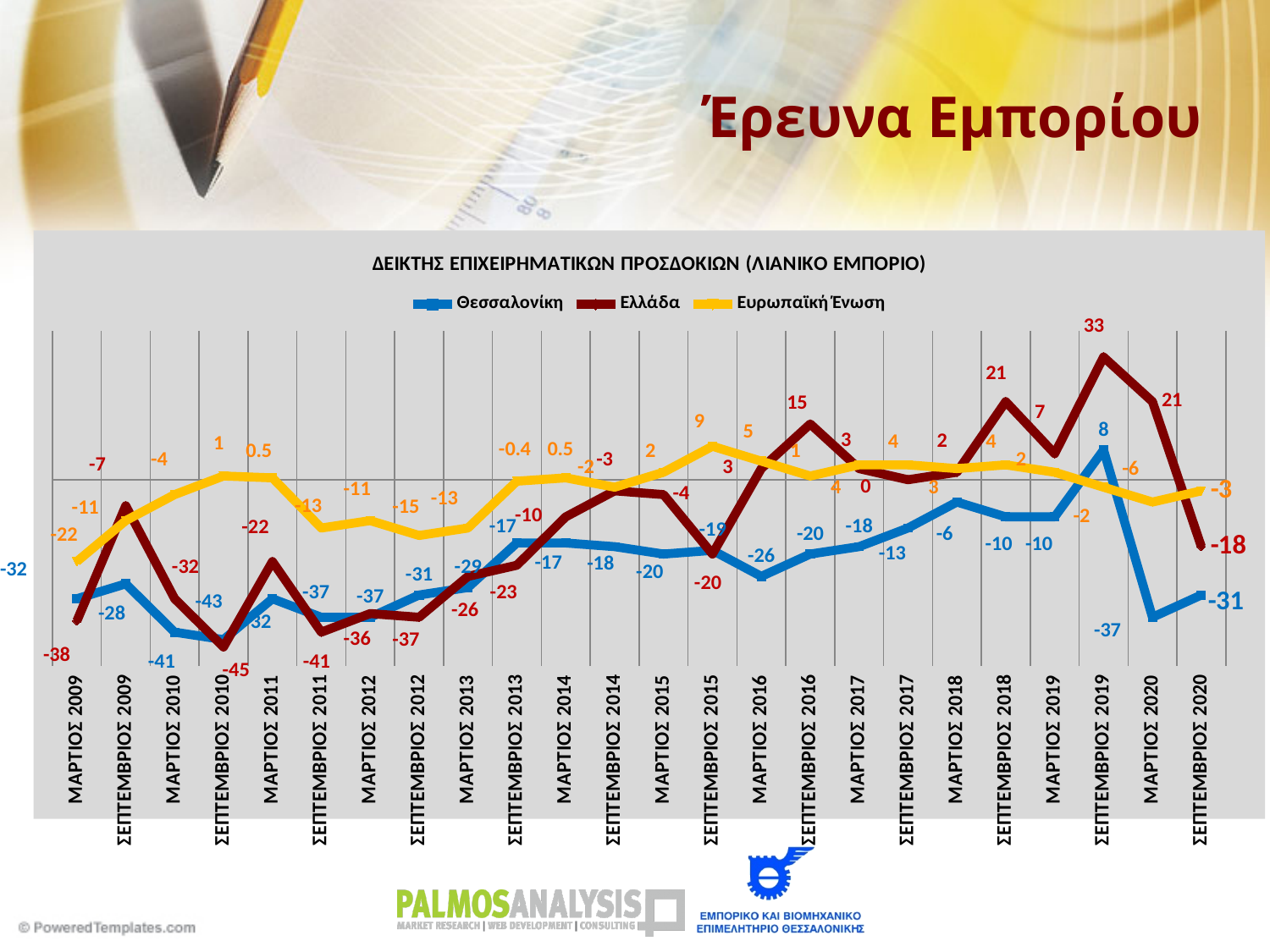
What is the difference between the Ελλάδα values in ΣΕΠΤΕΜΒΡΙΟΣ 2019 and ΣΕΠΤΕΜΒΡΙΟΣ 2020? 51 How many time periods are shown on the x axis? 24 In ΣΕΠΤΕΜΒΡΙΟΣ 2020, which series has the higher value, Ελλάδα or Θεσσαλονίκη? Ελλάδα What type of chart is shown on the slide? line chart What is the value for Θεσσαλονίκη in ΣΕΠΤΕΜΒΡΙΟΣ 2020? -31 What is the value for Ελλάδα in ΣΕΠΤΕΜΒΡΙΟΣ 2020? -18 What is the value for Ελλάδα in ΣΕΠΤΕΜΒΡΙΟΣ 2019? 33 How many series does the legend list? 3 In which period does the Ελλάδα series reach its highest value? ΣΕΠΤΕΜΒΡΙΟΣ 2019 What is the value for Θεσσαλονίκη in ΜΑΡΤΙΟΣ 2020? -37 In which period does the Ελλάδα series reach its lowest value? ΣΕΠΤΕΜΒΡΙΟΣ 2010 What is the title of the chart? ΔΕΙΚΤΗΣ ΕΠΙΧΕΙΡΗΜΑΤΙΚΩΝ ΠΡΟΣΔΟΚΙΩΝ (ΛΙΑΝΙΚΟ ΕΜΠΟΡΙΟ)